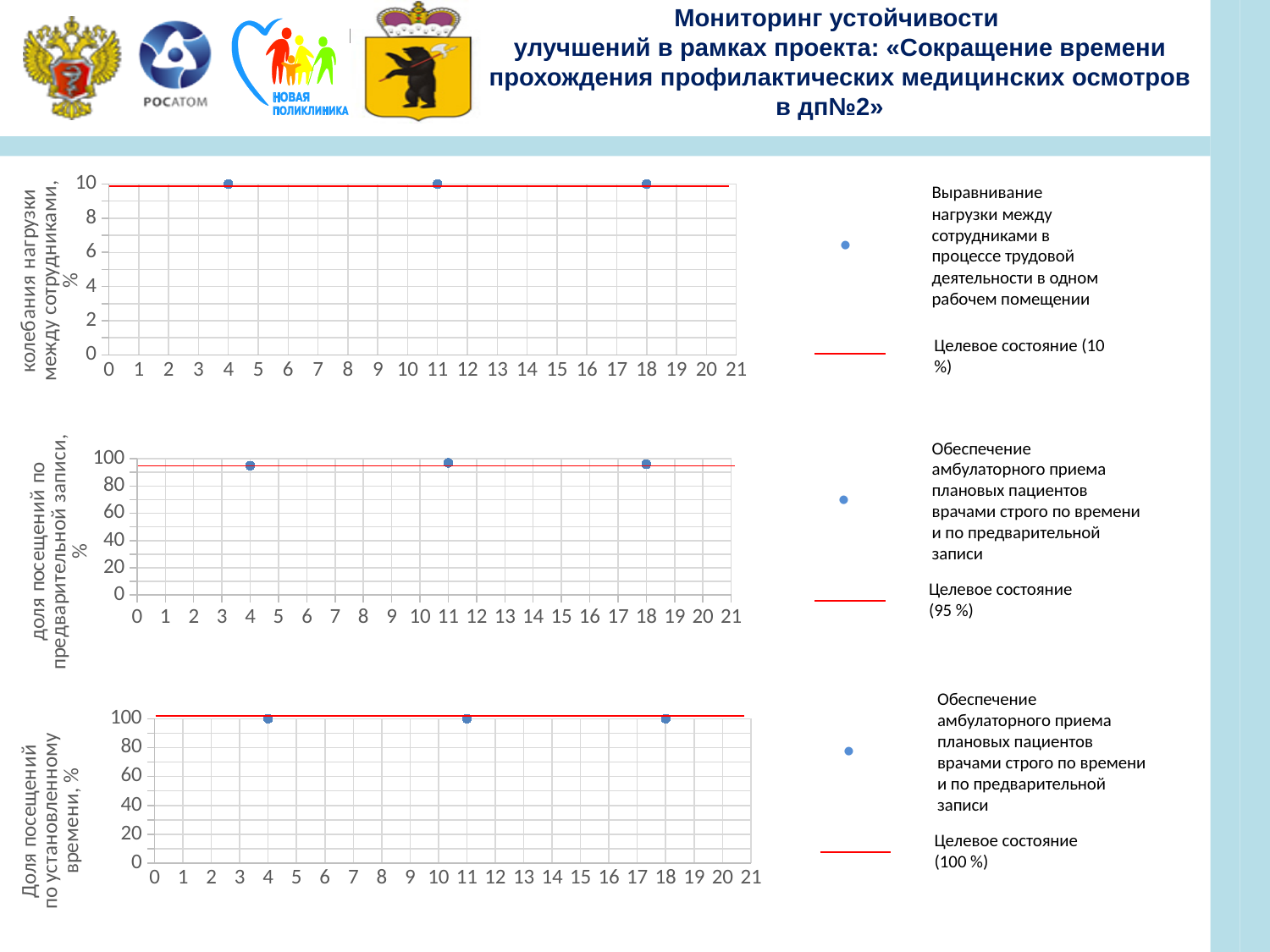
On the top chart, is the value of the blue point at x = 4 greater or less than 6? greater What kind of chart is the top chart? scatter chart On the top chart, how many data points are plotted for the blue series? 3 On the middle chart, how many data points are plotted for the blue series? 3 On the bottom chart, what target value does the red line represent according to the legend? 100 % On the top chart, what target value does the red line represent according to the legend? 10 % On the bottom chart, is the value of the blue point at x = 18 greater or less than 60? greater On the middle chart, what target value does the red line represent according to the legend? 95 % How many series does the legend of the middle chart list? 2 On the bottom chart, how many data points are plotted for the blue series? 3 What is the highest tick value shown on the x axis of the bottom chart? 21 On the middle chart, is the value of the blue point at x = 11 greater or less than 80? greater